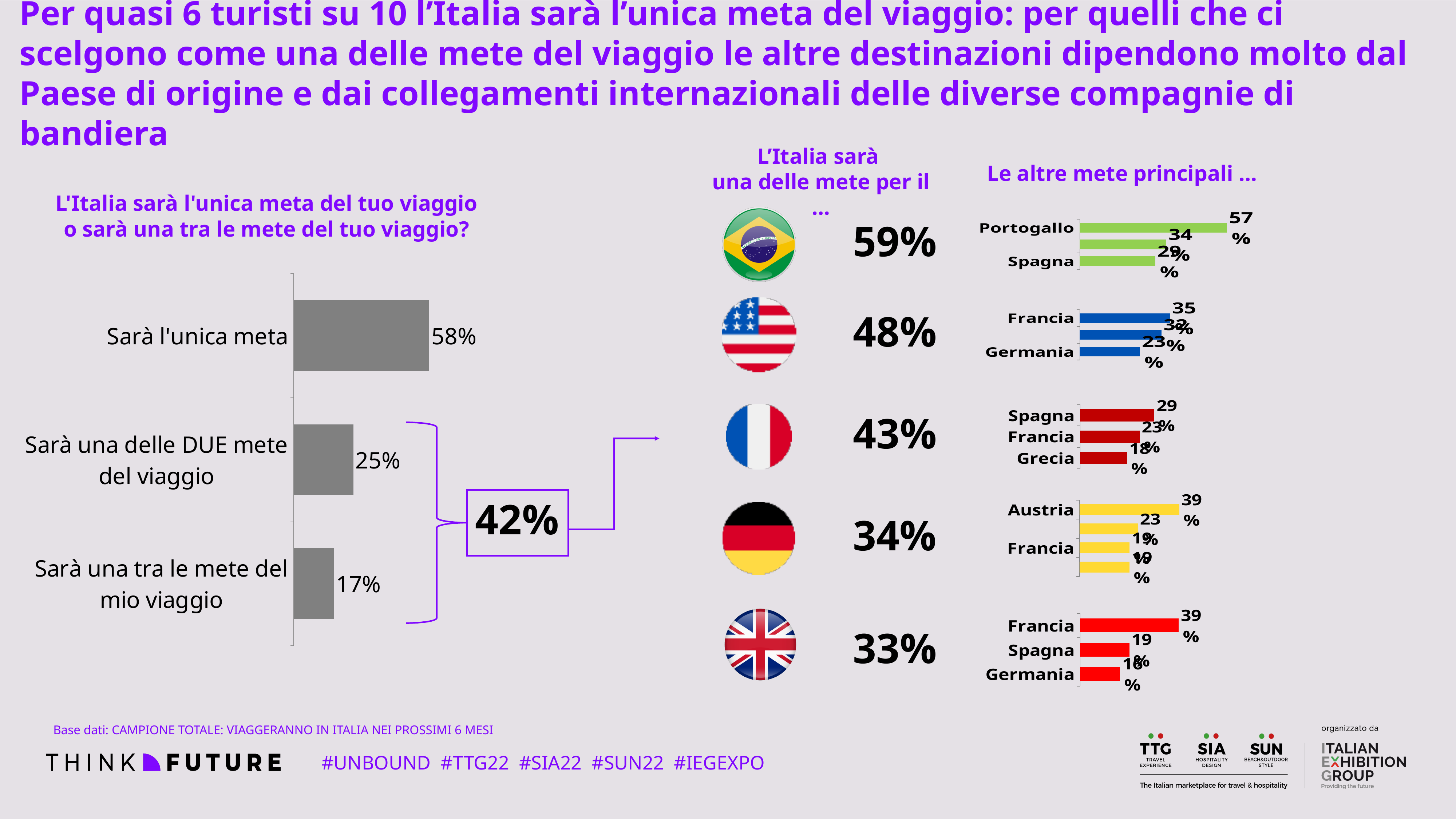
In the chart 'L'Italia sarà l'unica meta del tuo viaggio o sarà una tra le mete del tuo viaggio?', how many categories are shown? 3 In the 'Le altre mete principali' chart next to the Brazilian flag, what is the value for Portogallo? 57% In the 'Le altre mete principali' chart next to the French flag, which destination has the lowest value? Grecia In the chart 'L'Italia sarà l'unica meta del tuo viaggio o sarà una tra le mete del tuo viaggio?', which category has the highest value? Sarà l'unica meta In the chart 'L'Italia sarà l'unica meta del tuo viaggio o sarà una tra le mete del tuo viaggio?', which category has the lowest value? Sarà una tra le mete del mio viaggio In the chart 'L'Italia sarà l'unica meta del tuo viaggio o sarà una tra le mete del tuo viaggio?', what is the value for 'Sarà una tra le mete del mio viaggio'? 17% In the 'Le altre mete principali' chart next to the US flag, what is the value for Francia? 35% In the chart 'L'Italia sarà l'unica meta del tuo viaggio o sarà una tra le mete del tuo viaggio?', what is the difference between 'Sarà l'unica meta' and 'Sarà una delle DUE mete del viaggio'? 33% In the chart 'L'Italia sarà l'unica meta del tuo viaggio o sarà una tra le mete del tuo viaggio?', what combined value is shown in the box for the two 'una delle mete' categories? 42% In the chart 'L'Italia sarà l'unica meta del tuo viaggio o sarà una tra le mete del tuo viaggio?', what is the value for 'Sarà l'unica meta'? 58% What kind of chart is 'L'Italia sarà l'unica meta del tuo viaggio o sarà una tra le mete del tuo viaggio?'? Bar chart In the chart 'L'Italia sarà l'unica meta del tuo viaggio o sarà una tra le mete del tuo viaggio?', what is the value for 'Sarà una delle DUE mete del viaggio'? 25%